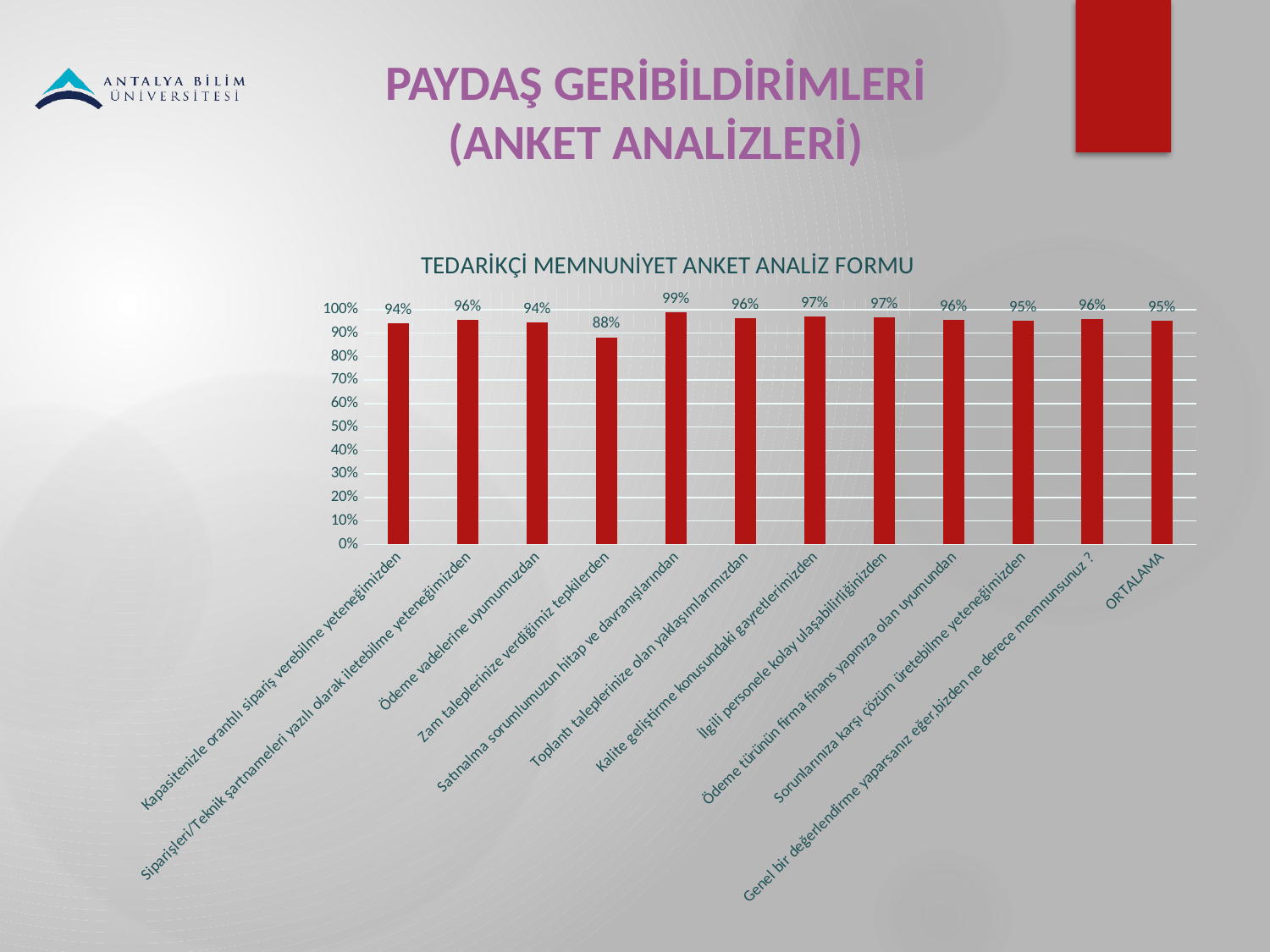
What is the difference between the highest value (99%) and the lowest value (88%)? 11% What is the value for "Zam taleplerinize verdiğimiz tepkilerden"? 88% How many bars are shown in the chart? 12 What is the value for ORTALAMA? 95% Which is larger: the value for "Kalite geliştirme konusundaki gayretlerimizden" or the value for "Kapasitenizle orantılı sipariş verebilme yeteneğimizden"? Kalite geliştirme konusundaki gayretlerimizden What type of chart is shown on the slide? Bar chart What is the title of the chart? TEDARİKÇİ MEMNUNİYET ANKET ANALİZ FORMU Which category has the highest value? Satınalma sorumlumuzun hitap ve davranışlarından What is the value for "Satınalma sorumlumuzun hitap ve davranışlarından"? 99% What is the value for "Ödeme vadelerine uyumumuzdan"? 94% Which category has the lowest value? Zam taleplerinize verdiğimiz tepkilerden Is the value for "Zam taleplerinize verdiğimiz tepkilerden" greater or less than 90%? less